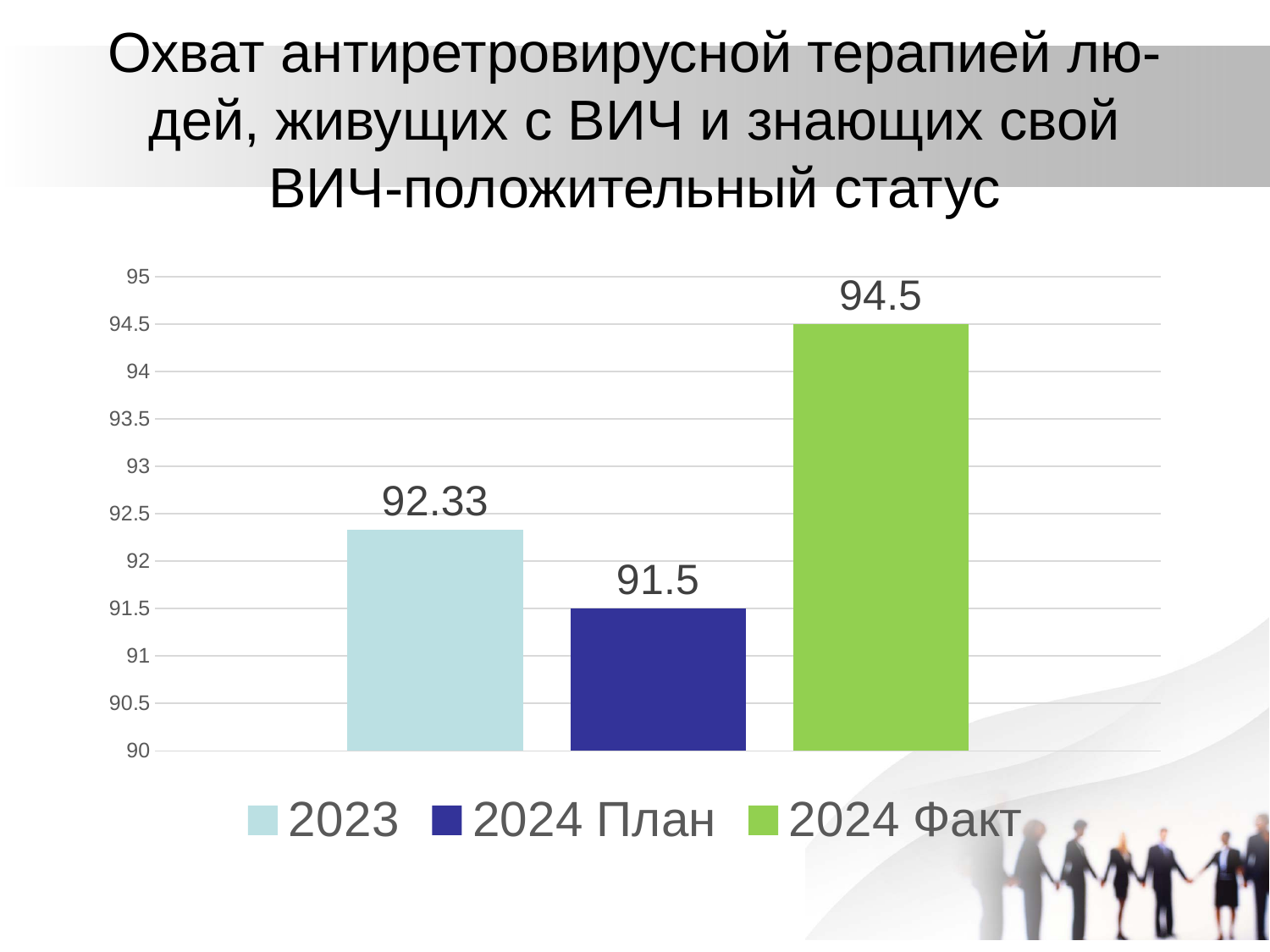
What is the value for 2023? 92.33 Which series has the highest value? 2024 Факт Which series has the lowest value? 2024 План What is the difference between the 2024 Факт value and the 2024 План value? 3 What kind of chart is shown on the slide? bar chart How many bars are plotted on the chart? 3 Is the value for 2023 greater or less than 92? greater What is the value for 2024 План? 91.5 How many series does the legend list? 3 Which is larger, the value for 2023 or the value for 2024 Факт? 2024 Факт What is the difference between the 2023 value and the 2024 План value? 0.83 What is the value for 2024 Факт? 94.5